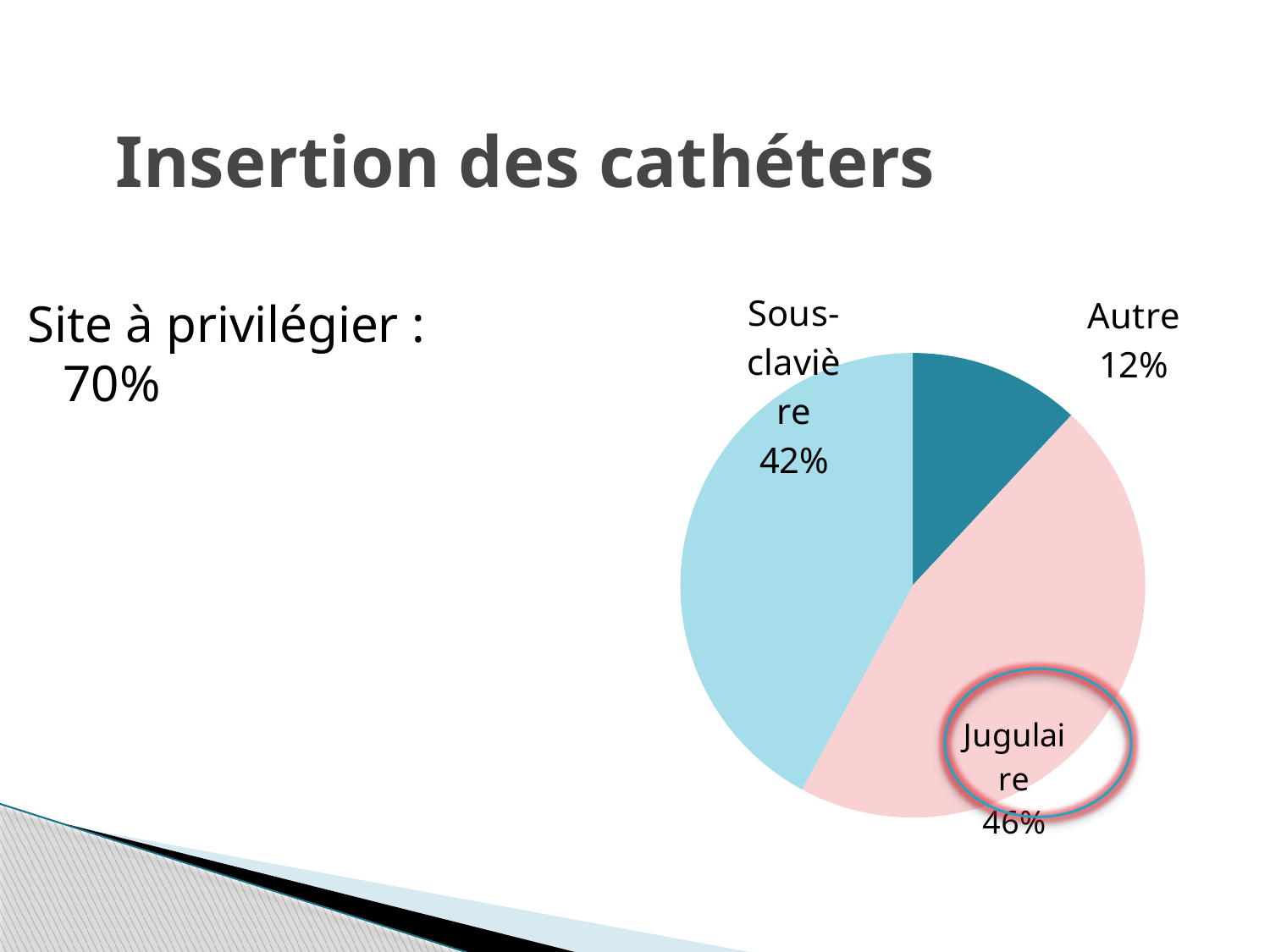
Which is larger, the Jugulaire slice or the Autre slice? Jugulaire What is the difference in percentage points between Jugulaire and Sous-clavière? 4 What share of the pie does Sous-clavière represent? 42% Which category has the largest slice of the pie? Jugulaire What share of the pie does Autre represent? 12% Which category has the smallest slice of the pie? Autre What kind of chart is shown on the slide? pie chart How many slices does the pie chart have? 3 What colour is the Sous-clavière slice? light blue Which slice of the pie is circled on the slide? Jugulaire What share of the pie does Jugulaire represent? 46% What is the difference in percentage points between Sous-clavière and Autre? 30